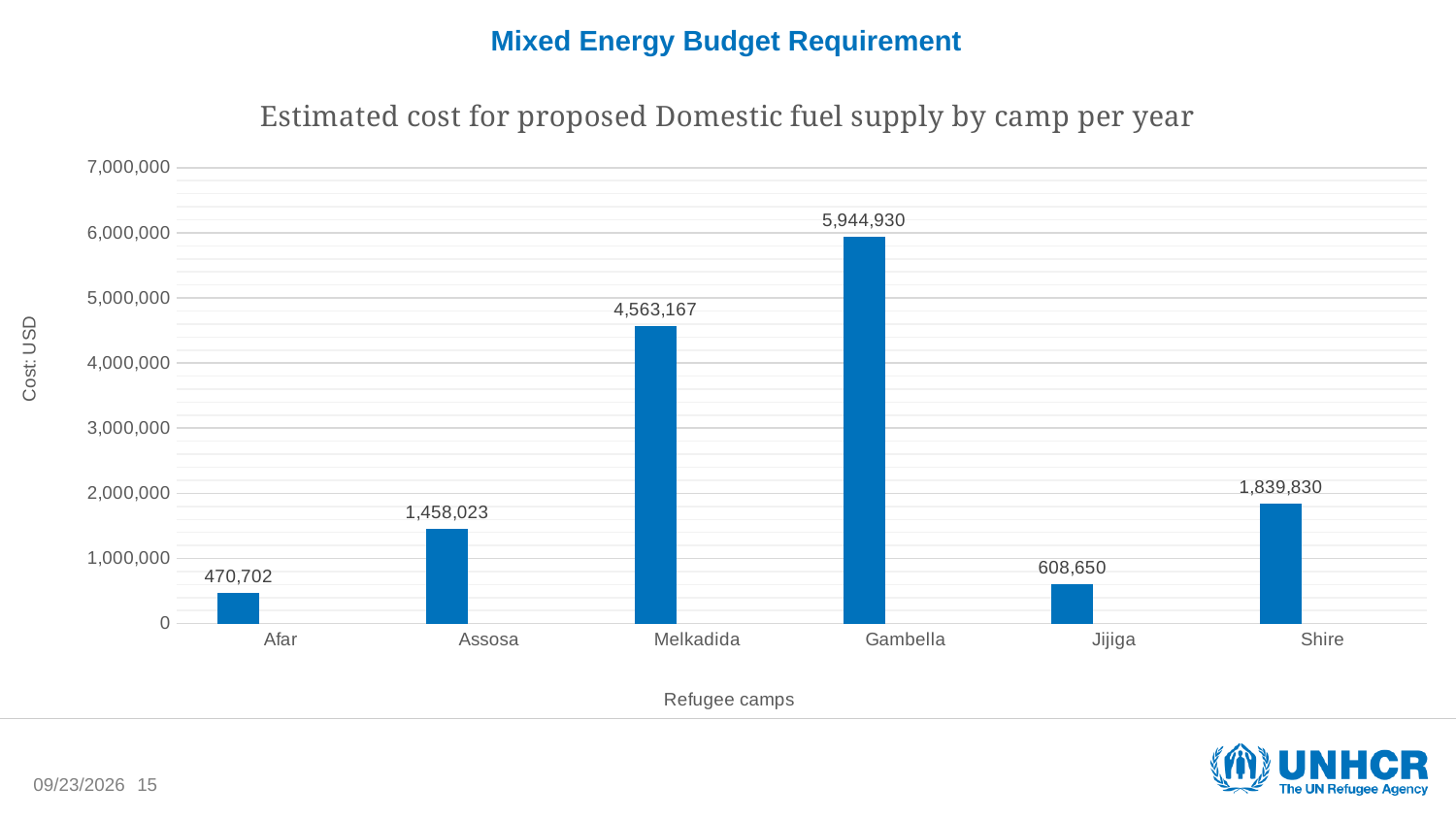
What is the difference between the estimated costs for Shire and Assosa? 381,807 Which refugee camp has the highest estimated cost? Gambella What is the estimated cost for Assosa? 1,458,023 What is the difference between the estimated costs for Gambella and Melkadida? 1,381,763 What is the estimated cost for Gambella? 5,944,930 Which has a higher estimated cost, Shire or Assosa? Shire What kind of chart is shown on the slide? Bar chart Which refugee camp has the lowest estimated cost? Afar How many refugee camps are shown on the chart? 6 What is the estimated cost for Jijiga? 608,650 Is the value for Melkadida greater or less than 4,000,000? greater What is the label of the vertical axis? Cost: USD